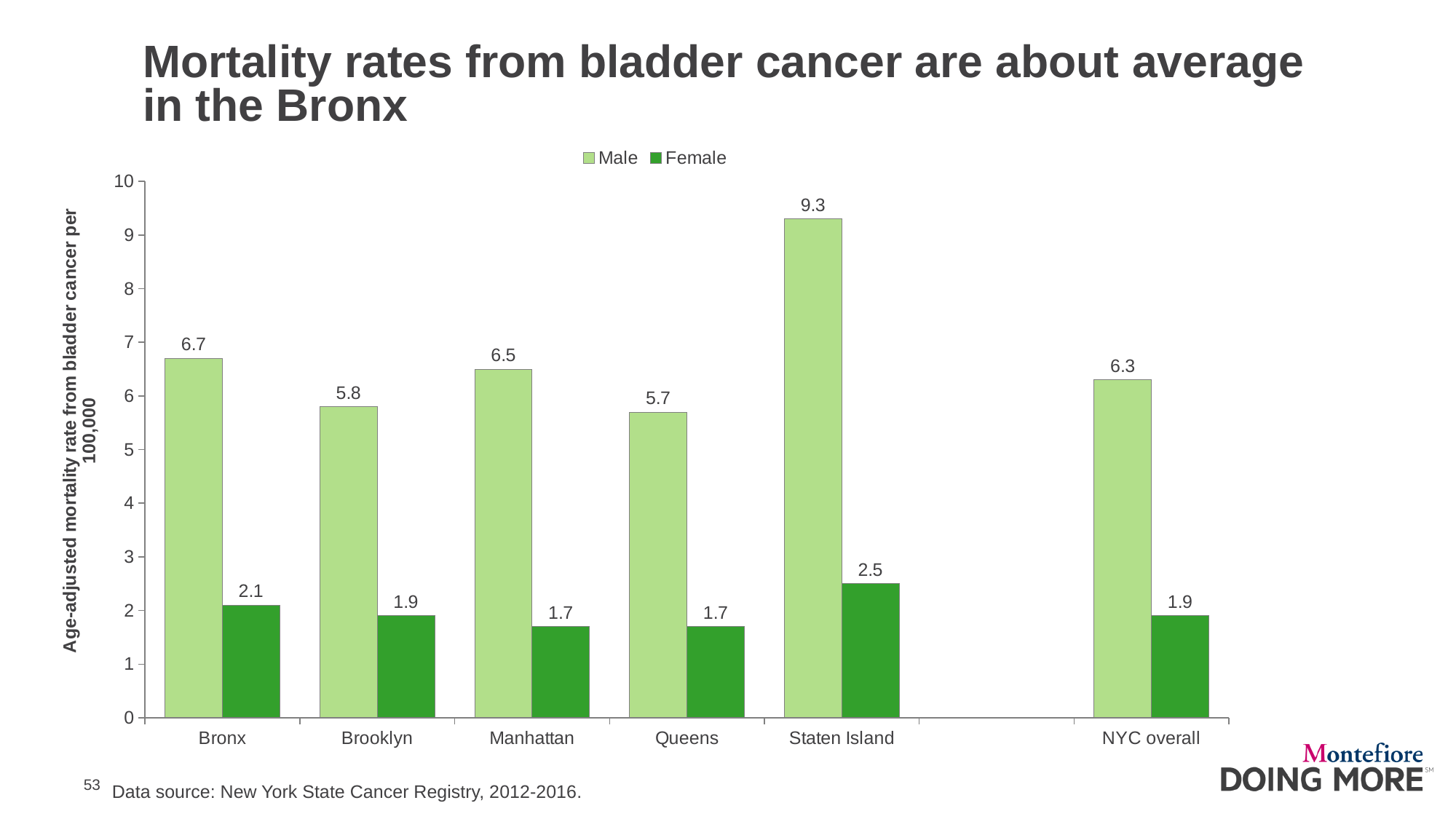
What is the difference between the Male and Female mortality rates in the Bronx? 4.6 Is the Male mortality rate for Staten Island greater or less than 9? greater What is the Male mortality rate for Staten Island? 9.3 How many series does the legend list? 2 How many categories are shown on the x axis? 6 Which is larger, the Male rate for the Bronx or the Male rate for Brooklyn? Bronx Which borough has the highest Male mortality rate? Staten Island What is the data source cited on the slide? New York State Cancer Registry, 2012-2016 What kind of chart is shown on the slide? bar chart What is the Female mortality rate for the Bronx? 2.1 Which borough has the lowest Male mortality rate? Queens What is the Male mortality rate for NYC overall? 6.3